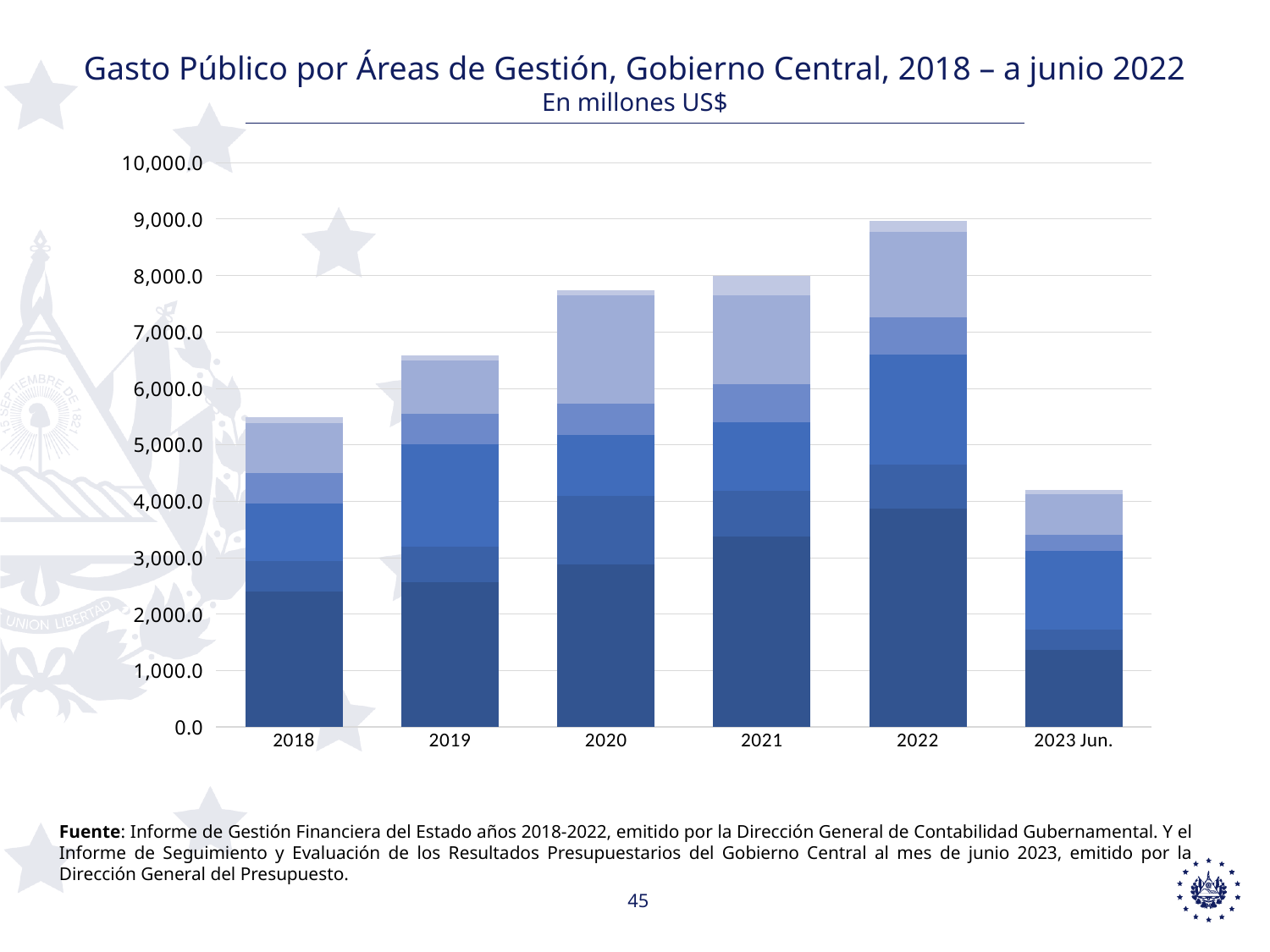
Is the total value for 2020 greater or less than 7,000.0? greater What kind of chart is shown on the slide? Stacked bar chart Do the bar totals rise or fall from 2018 to 2022? rise Is the total value for 2023 Jun. greater or less than 5,000.0? less Which category has the shortest bar in the chart? 2023 Jun. In what units are the values of the chart expressed, according to the subtitle? En millones US$ Is the total value for 2018 greater or less than 5,000.0? greater Which bar is taller, 2019 or 2020? 2020 Which year has the tallest bar in the chart? 2022 How many categories (years) are shown on the x axis of the chart? 6 What is the title of the chart? Gasto Público por Áreas de Gestión, Gobierno Central, 2018 – a junio 2022